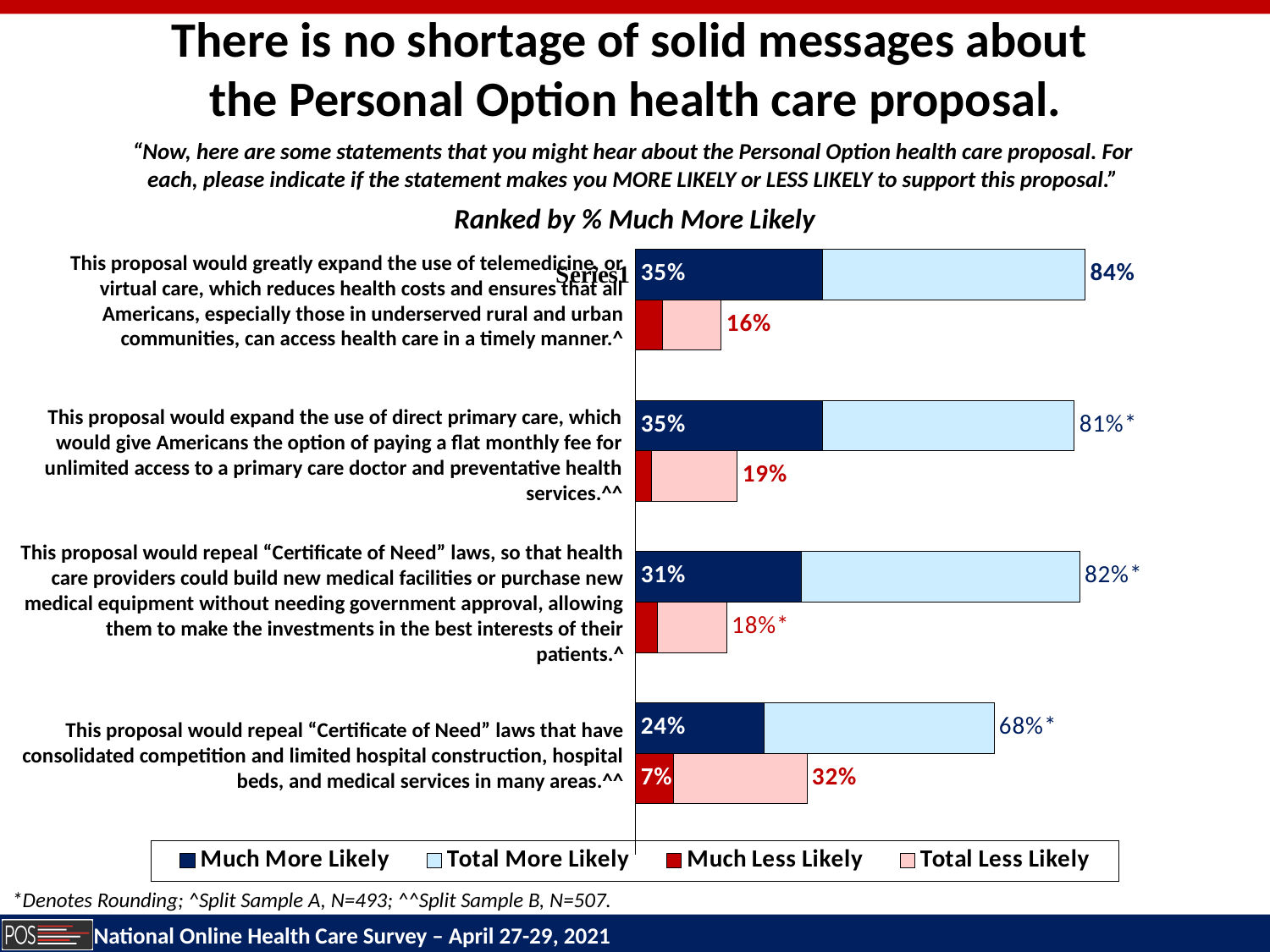
What is the Total Less Likely value for the statement about repealing "Certificate of Need" laws that have consolidated competition and limited hospital construction? 32% How many statements are shown in the chart? 4 What is the difference between the Total More Likely and Total Less Likely values for the telemedicine statement? 68 percentage points Is the Total Less Likely value larger for the direct primary care statement or for the telemedicine statement? Direct primary care statement Which legend entry is shown in dark navy blue? Much More Likely Which statement has the highest Total More Likely value? This proposal would greatly expand the use of telemedicine, or virtual care How many series does the legend list? 4 What is the Much Less Likely value for the statement about repealing "Certificate of Need" laws that have consolidated competition? 7% What is the Total More Likely value for the statement about expanding direct primary care? 81%* What percentage of respondents said the telemedicine statement makes them Much More Likely to support the proposal? 35% What type of chart is shown on the slide? Bar chart Which statement has the lowest Much More Likely value? This proposal would repeal "Certificate of Need" laws that have consolidated competition and limited hospital construction